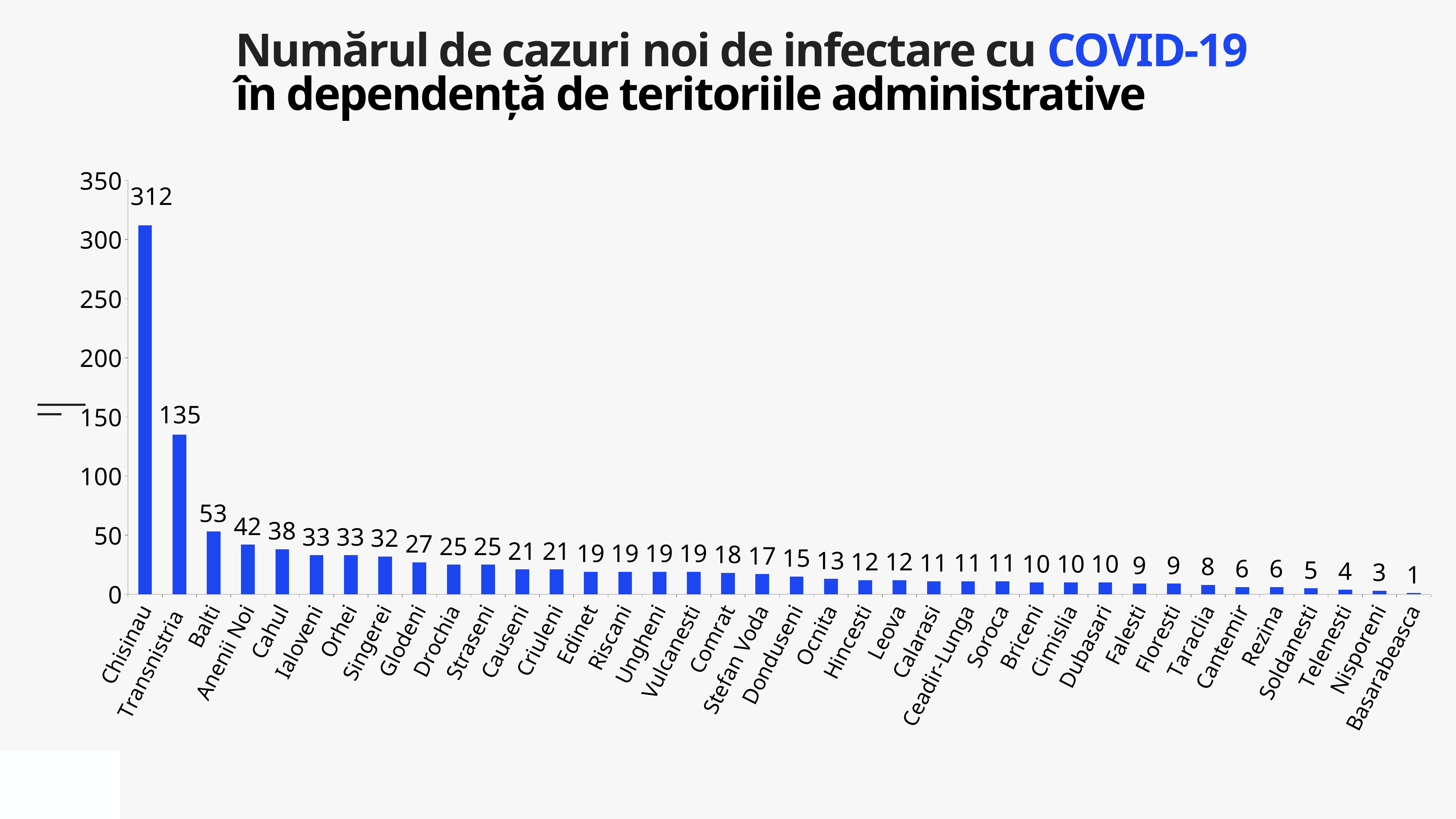
What is the value for Chisinau? 312 Which territory has the highest number of new cases? Chisinau Do the values rise or fall from left to right along the x axis? Fall Which territory has the lowest number of new cases? Basarabeasca What is the difference between the values for Chisinau and Transnistria? 177 What kind of chart is this? Bar chart What is the value for Cahul? 38 What is the value for Transnistria? 135 What is the value for Ceadir-Lunga? 11 What is the difference between the values for Balti and Anenii Noi? 11 Which is larger, the value for Glodeni or the value for Comrat? Glodeni How many territories are shown on the x axis? 38